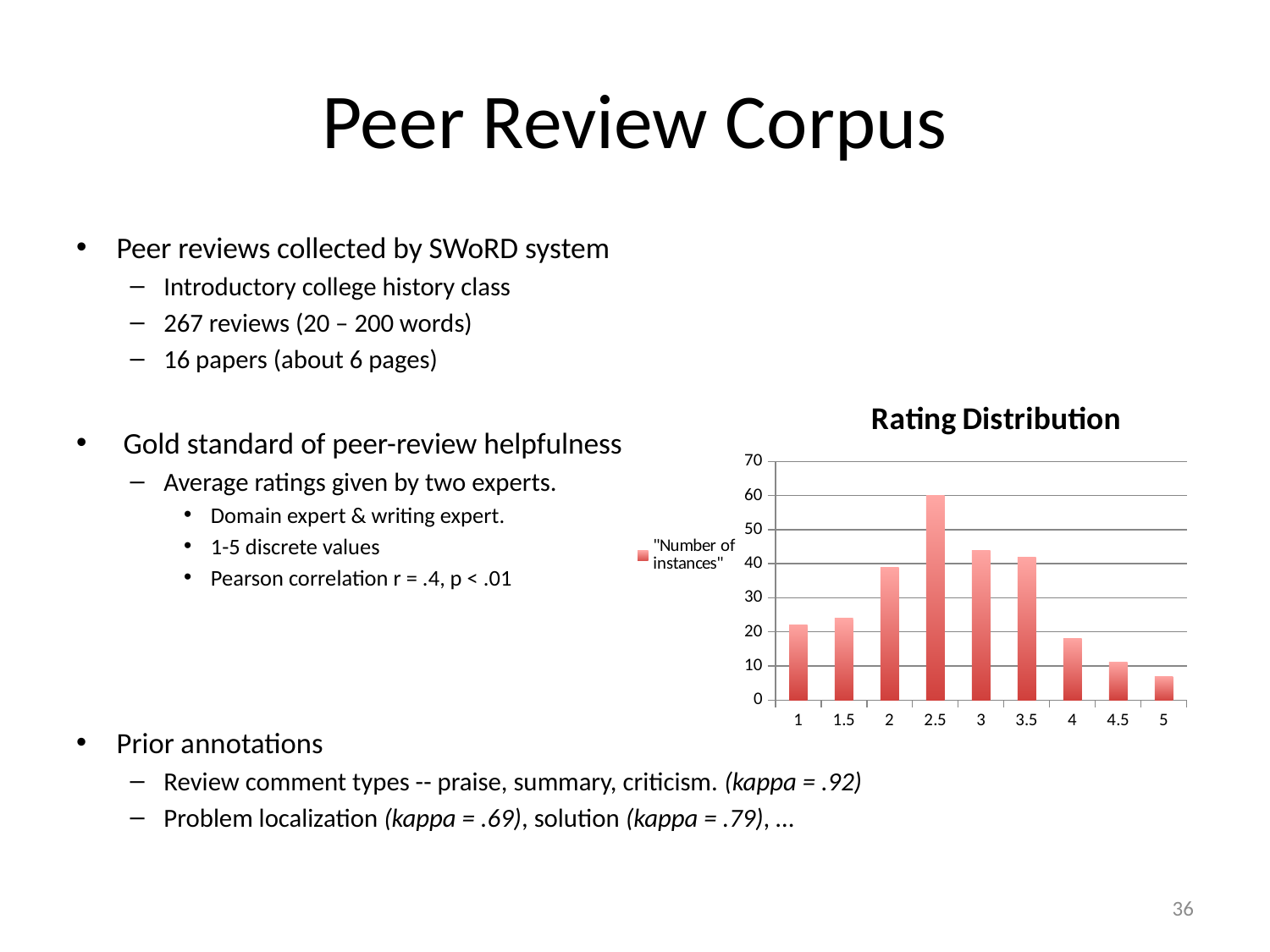
What is the name of the series in the legend of the Rating Distribution chart? "Number of instances" What type of chart is shown under the title "Rating Distribution"? bar chart Which rating category has the lowest number of instances in the Rating Distribution chart? 5 In the Rating Distribution chart, which has more instances: rating 3 or rating 4? 3 How many series does the legend of the Rating Distribution chart list? 1 In the Rating Distribution chart, is the number of instances for rating 5 greater or less than 10? less In the Rating Distribution chart, is the number of instances for rating 2.5 greater or less than 50? greater In the Rating Distribution chart, is the number of instances for rating 2 greater or less than 30? greater What is the title of the chart on the slide? Rating Distribution Which rating category has the highest number of instances in the Rating Distribution chart? 2.5 How many rating categories are shown on the x axis of the Rating Distribution chart? 9